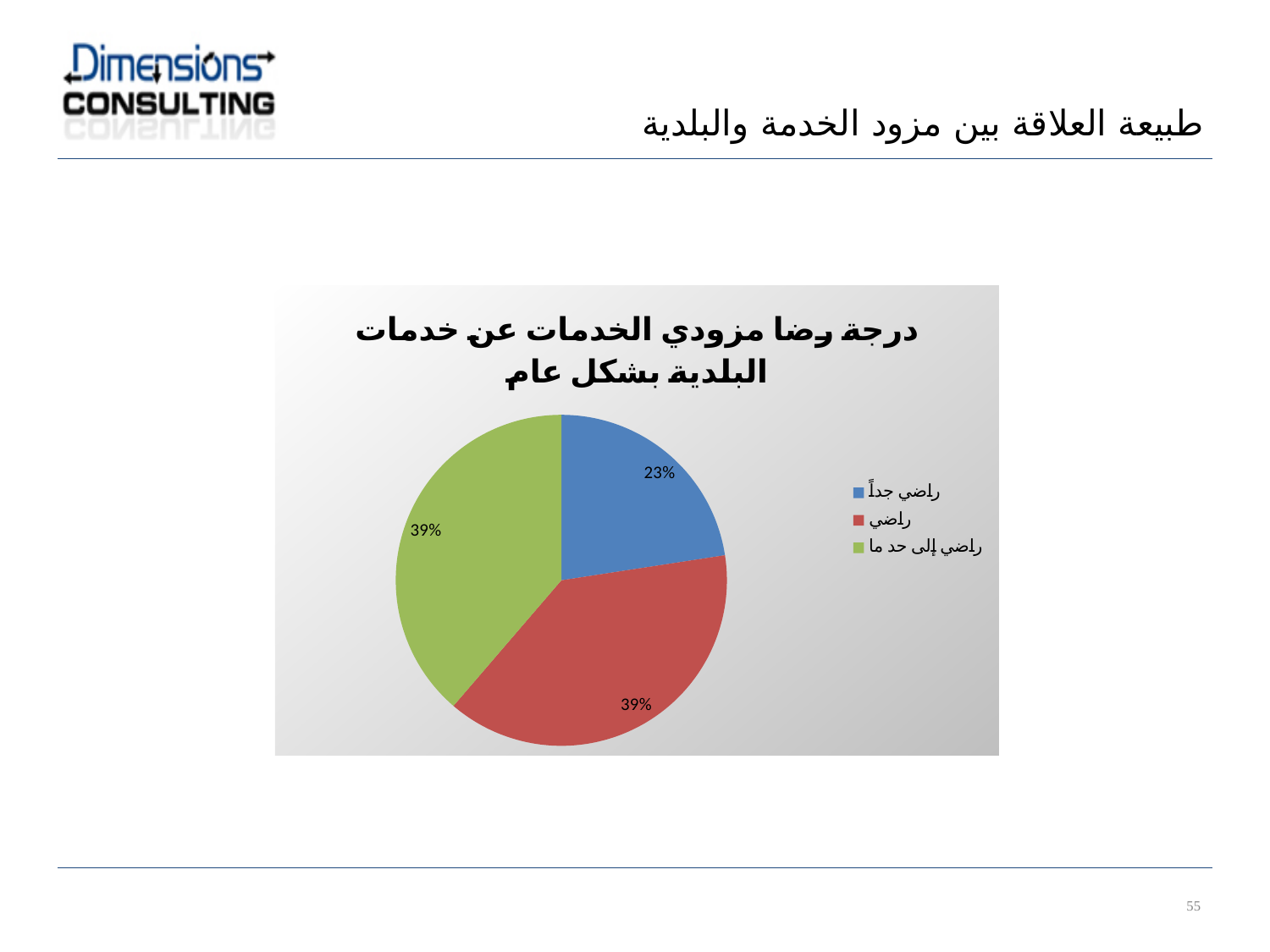
What colour is the "راضي إلى حد ما" slice? green What kind of chart is shown on the slide? pie chart Which category has the smallest slice of the pie? راضي جداً What share of the pie does the "راضي جداً" slice represent? 23% How many slices does the pie chart have? 3 What is the title of the pie chart? درجة رضا مزودي الخدمات عن خدمات البلدية بشكل عام What share of the pie does the "راضي" slice represent? 39% What is the difference in percentage points between the "راضي إلى حد ما" slice and the "راضي جداً" slice? 16 How many entries does the legend list? 3 Which is larger, the slice for "راضي" or the slice for "راضي جداً"? راضي What share of the pie does the "راضي إلى حد ما" slice represent? 39%